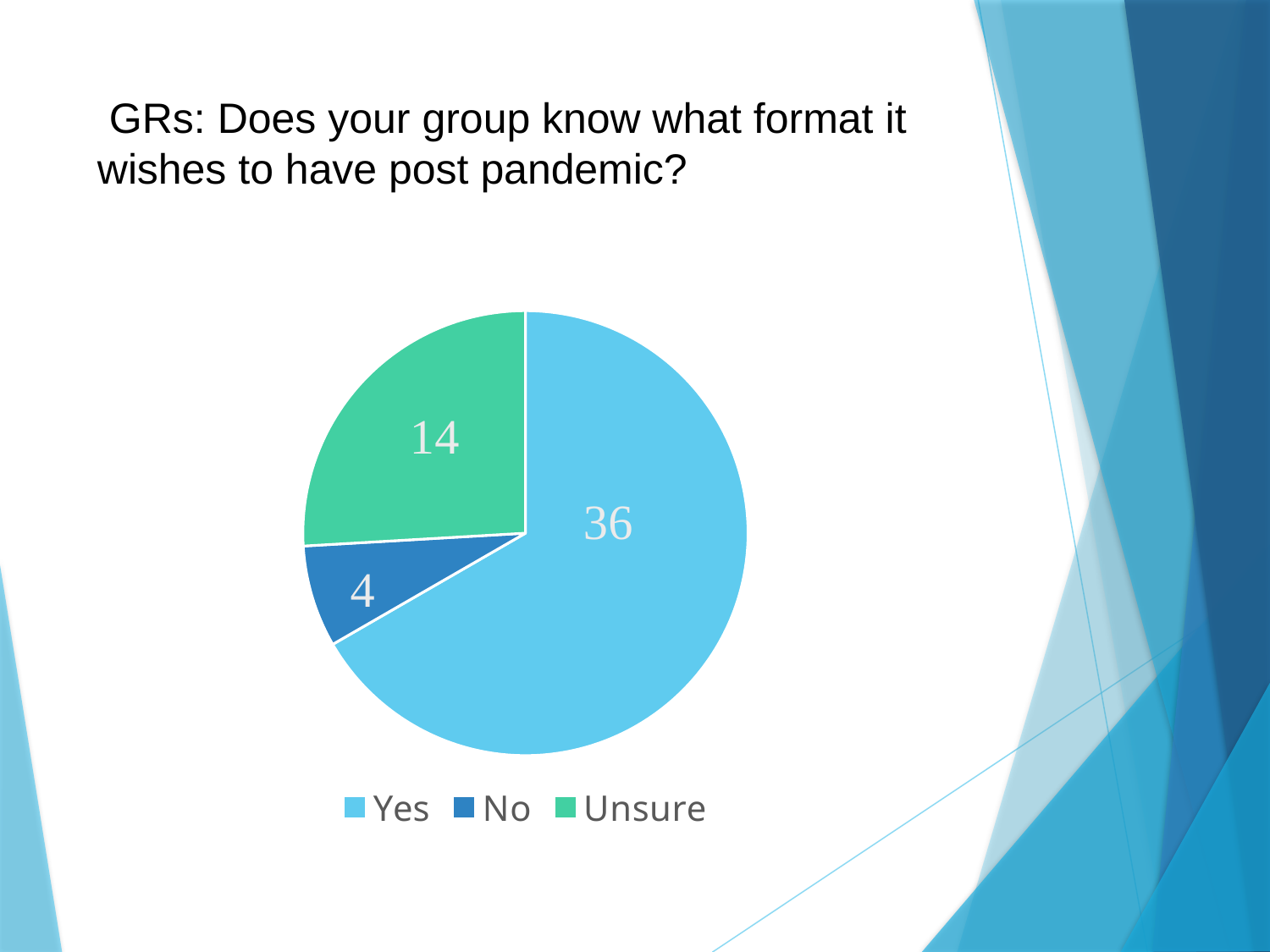
What is the total of all slices in the pie chart? 54 Which category has the smallest slice? No What type of chart is shown on the slide? pie chart What is the value for Yes? 36 What are the legend entries listed for the pie chart? Yes, No, Unsure Which category has the largest slice? Yes What is the difference between the Unsure and No values? 10 What is the value for Unsure? 14 What is the difference between the Yes and Unsure values? 22 How many categories does the pie chart have? 3 What is the value for No? 4 Which is larger, the value for Unsure or the value for No? Unsure